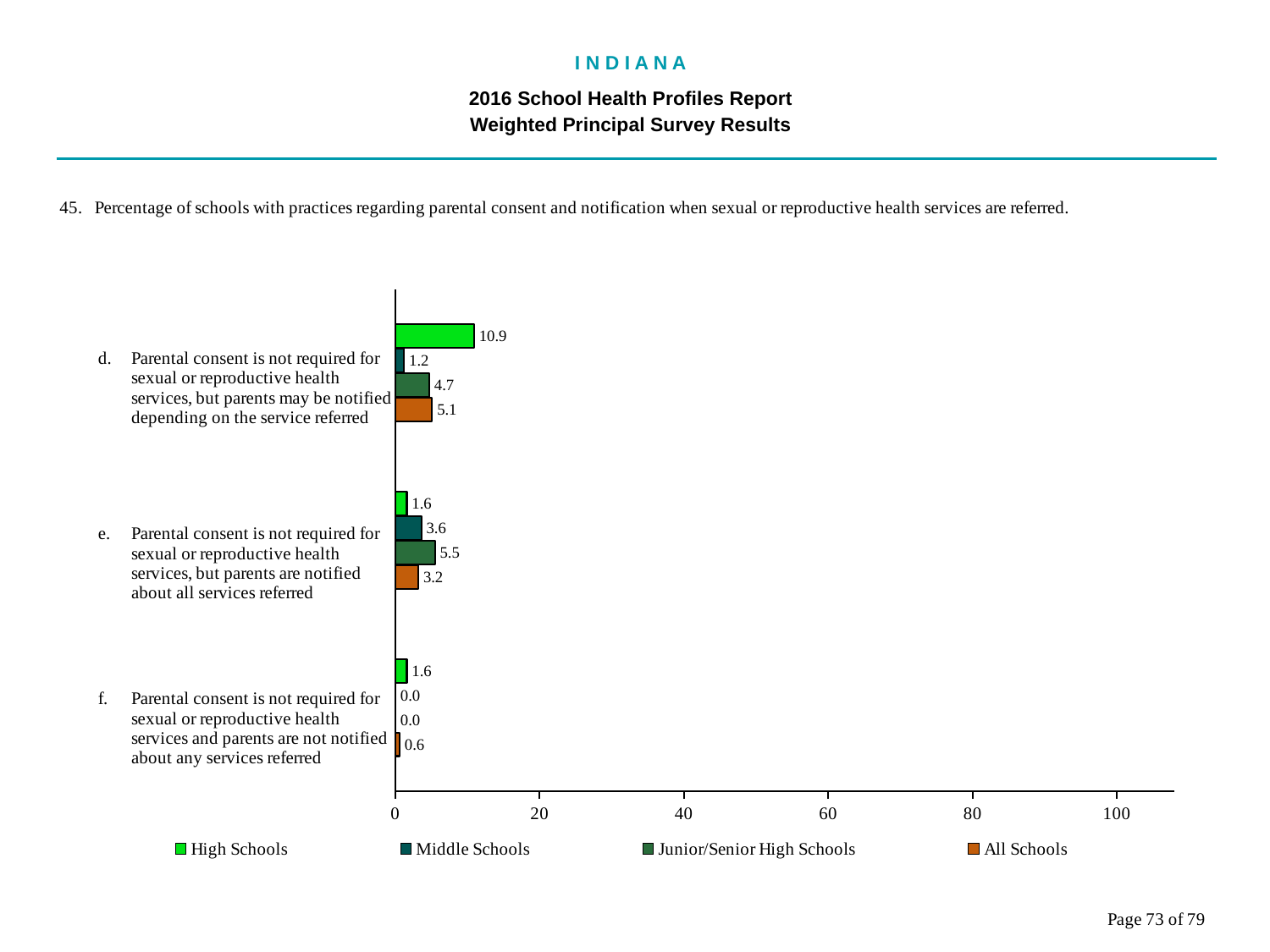
What is the difference between the High Schools value and the Middle Schools value for item d? 9.7 What is the value for High Schools for item d (parental consent not required, but parents may be notified depending on the service referred)? 10.9 Which school type has the highest value for item e? Junior/Senior High Schools What is the value for All Schools for item f (parental consent not required and parents are not notified about any services referred)? 0.6 What kind of chart is shown on the slide? Bar chart What is the value for Junior/Senior High Schools for item d? 4.7 For item e, which is larger: the Middle Schools value or the All Schools value? Middle Schools Which school type has the lowest value for item d? Middle Schools Which colour represents All Schools in the legend? Orange Which school type has the highest value for item d? High Schools How many series does the legend list? 4 What is the value for Middle Schools for item e (parental consent not required, but parents are notified about all services referred)? 3.6